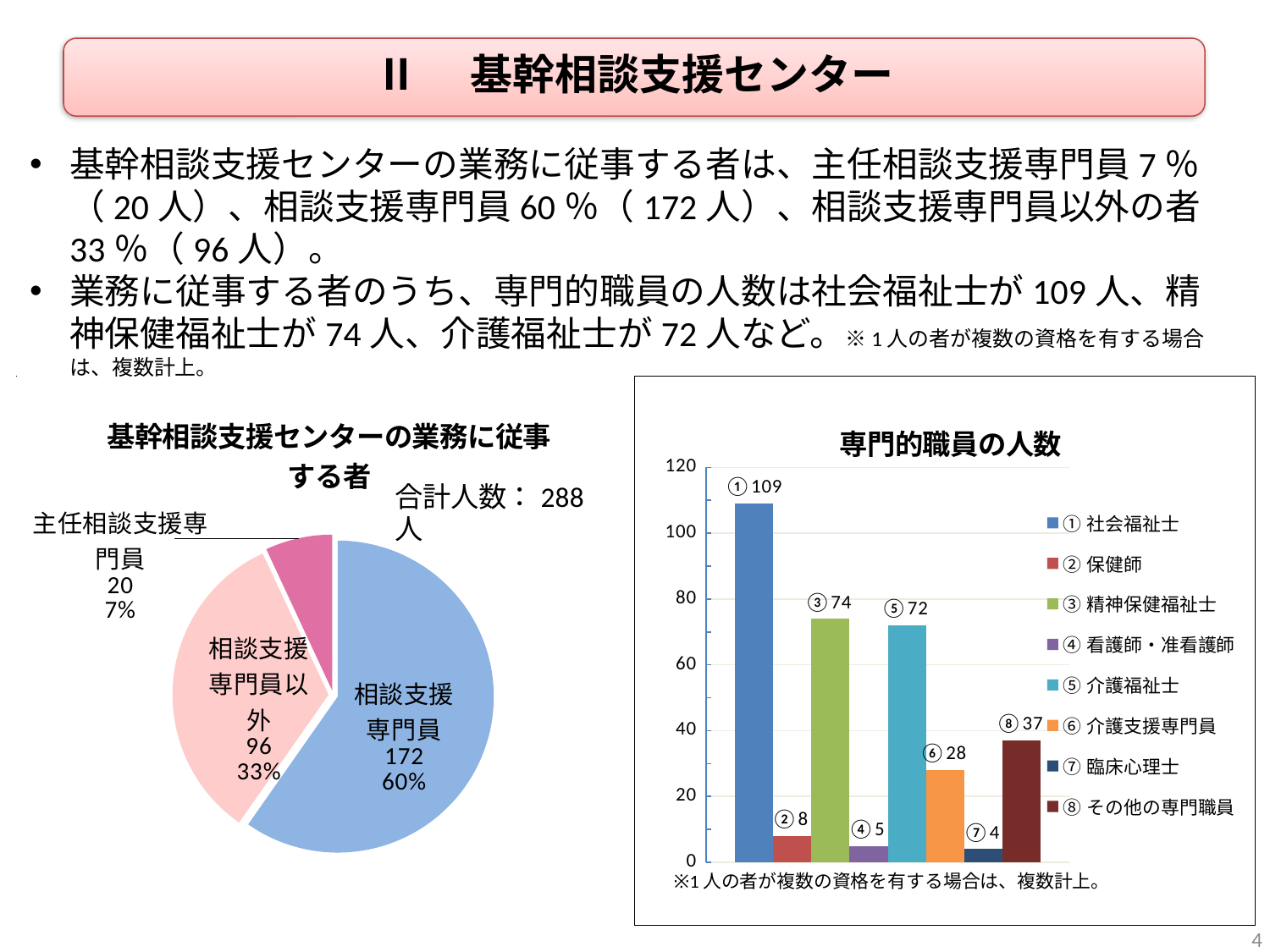
What kind of chart is the chart titled 専門的職員の人数? bar chart In the bar chart titled 専門的職員の人数, which category has the lowest value? ⑦ 臨床心理士 In the bar chart titled 専門的職員の人数, what is the difference between ① 社会福祉士 and ⑤ 介護福祉士? 37 In the pie chart titled 基幹相談支援センターの業務に従事する者, how many slices are there? 3 In the bar chart titled 専門的職員の人数, what is the value for ③ 精神保健福祉士? 74 In the bar chart titled 専門的職員の人数, which category has the highest value? ① 社会福祉士 In the pie chart titled 基幹相談支援センターの業務に従事する者, what is the value for 相談支援専門員? 172 In the pie chart titled 基幹相談支援センターの業務に従事する者, which slice is the smallest? 主任相談支援専門員 In the bar chart titled 専門的職員の人数, which is larger, ⑥ 介護支援専門員 or ⑧ その他の専門職員? ⑧ その他の専門職員 In the pie chart titled 基幹相談支援センターの業務に従事する者, what is the total number of people shown? 288人 In the bar chart titled 専門的職員の人数, how many series does the legend list? 8 In the pie chart titled 基幹相談支援センターの業務に従事する者, what share of the pie does 相談支援専門員以外 represent? 33%